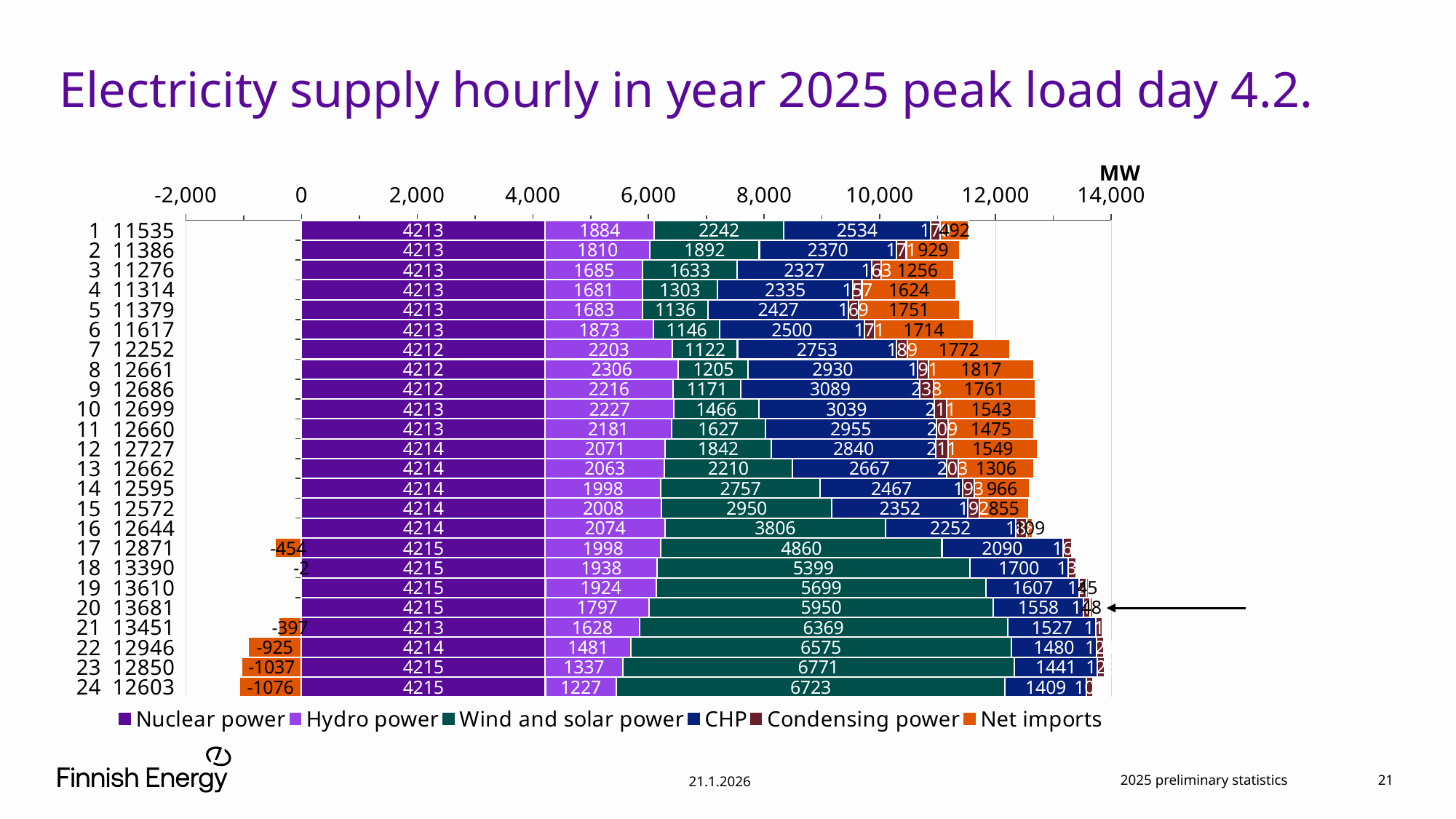
Which hour has the lowest total electricity supply? 3 Which hour has the larger CHP value, hour 9 or hour 1? hour 9 What is the total electricity supply printed for hour 20? 13681 What is the Hydro power value at hour 1? 1884 What unit is shown above the horizontal axis? MW Which hour has the highest total electricity supply? 20 How many series does the legend list? 6 What is the difference between the Wind and solar power values at hour 24 and hour 1? 4481 What is the Net imports value at hour 24? -1076 What kind of chart is shown on the slide? bar chart How many hours (categories) are plotted on the chart? 24 What is the Wind and solar power value at hour 20? 5950